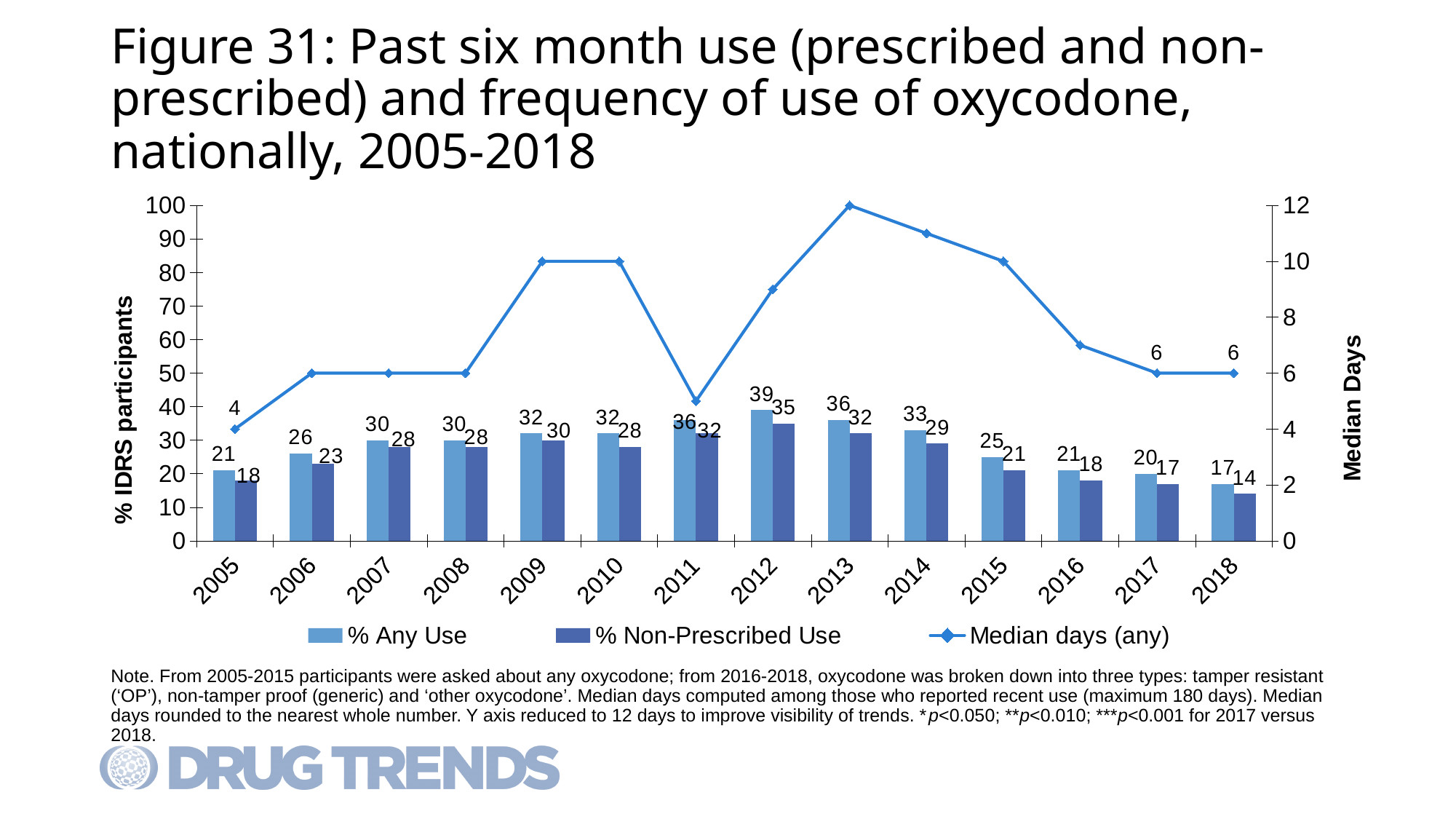
How many series does the legend list? 3 Does % Any Use rise or fall from 2012 to 2018? Fall How many years are shown on the x axis? 14 What is the % Non-Prescribed Use value for 2018? 14 What kind of chart is this? Combined bar and line chart What is the difference between % Any Use and % Non-Prescribed Use in 2012? 4 Is the Median days (any) value for 2013 greater or less than 10? greater What is the Median days (any) value labelled for 2005? 4 What is the % Any Use value for 2012? 39 Which is larger, % Any Use in 2013 or % Any Use in 2014? % Any Use in 2013 Which year has the highest % Any Use? 2012 Which year has the lowest % Non-Prescribed Use? 2018